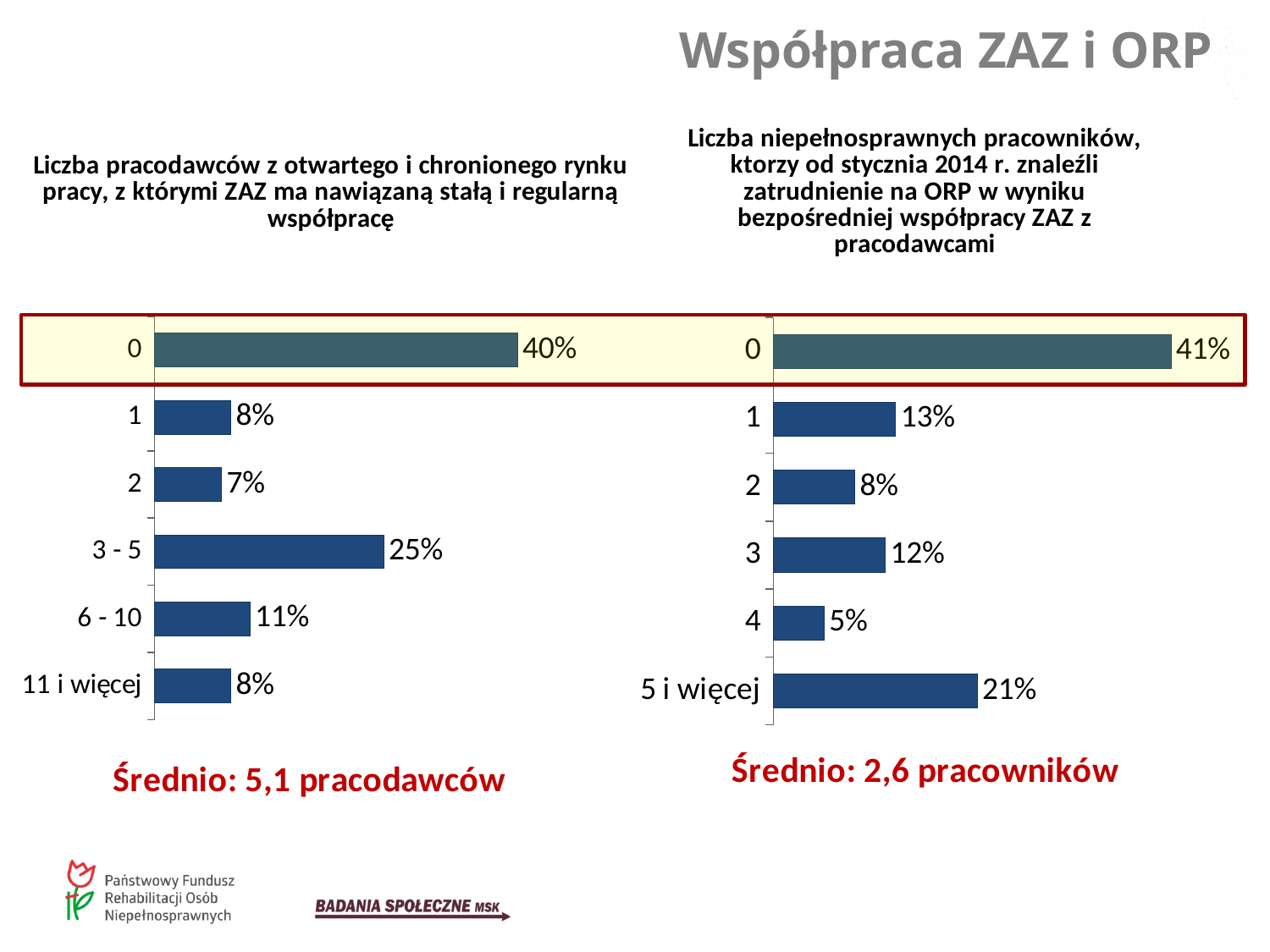
In the right chart, which is larger: the value for '3' or the value for '5 i więcej'? 5 i więcej What type of chart is the right chart? Bar chart How many categories does the right chart show? 6 How many categories does the left chart show? 6 In the left chart, which category has the highest value? 0 In the right chart, which category has the lowest value? 4 In the left chart (Liczba pracodawców...), what is the value for the category '3 - 5'? 25% In the left chart, what is the difference between the values for '0' and '3 - 5'? 15% In the right chart, what is the difference between the values for '1' and '2'? 5% In the right chart (Liczba niepełnosprawnych pracowników...), what is the value for the category '5 i więcej'? 21% In the left chart, which is larger: the value for '6 - 10' or the value for '2'? 6 - 10 What average value is stated below the left chart? Średnio: 5,1 pracodawców